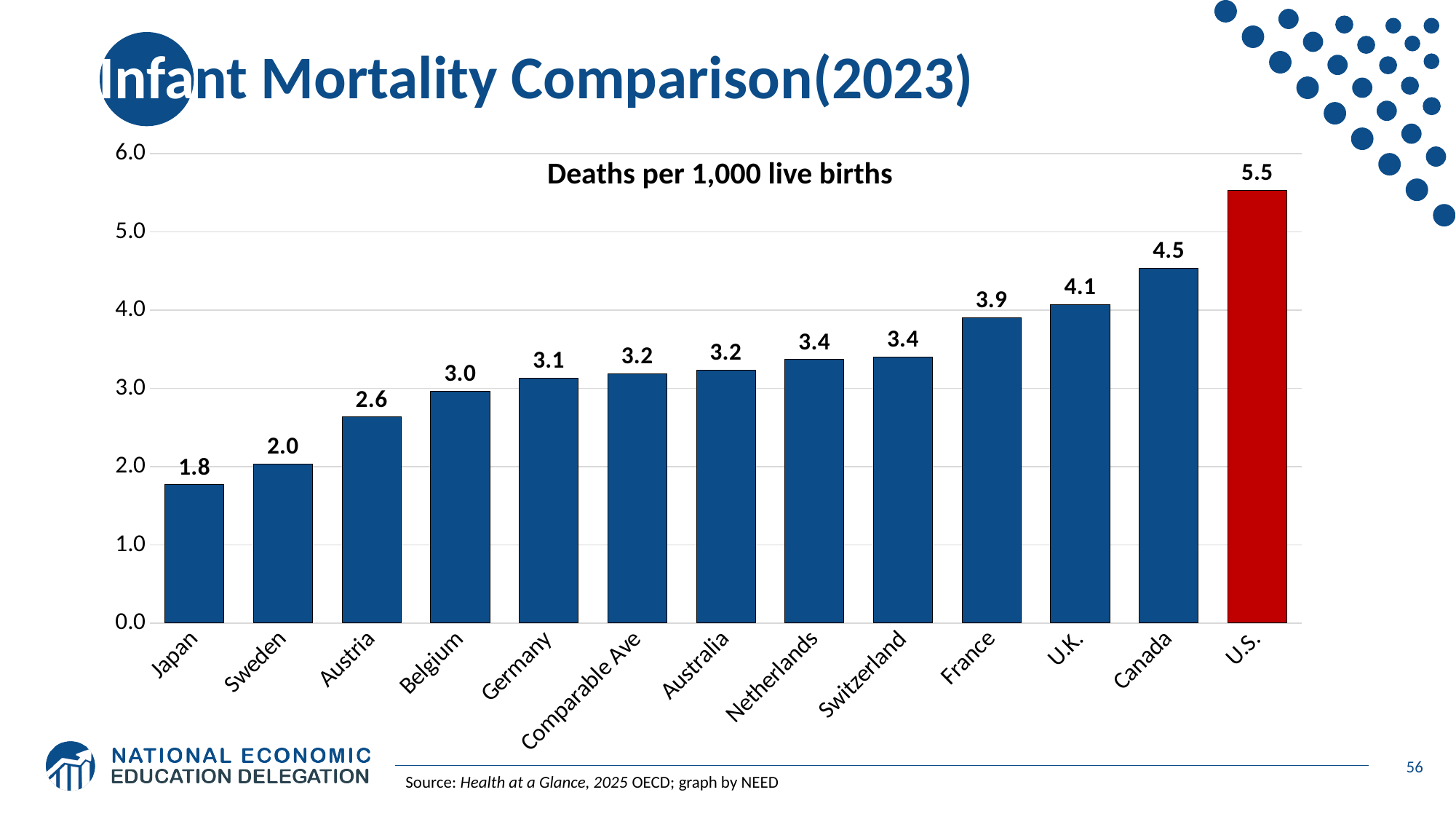
Which country has the lowest infant mortality rate on the chart? Japan Do the values rise or fall moving from left to right along the x axis? Rise Which bar is coloured red rather than blue? U.S. What is the value shown for the U.S.? 5.5 What is the infant mortality value for Japan? 1.8 What is the difference between the U.S. value and the Canada value? 1.0 What is the value shown for the Comparable Ave bar? 3.2 How many bars are shown on the chart? 13 Which country has the highest infant mortality rate on the chart? U.S. What kind of chart is shown on the slide? Bar chart Which has a higher value, France or Austria? France Is the value for the U.K. greater or less than 4.0? greater